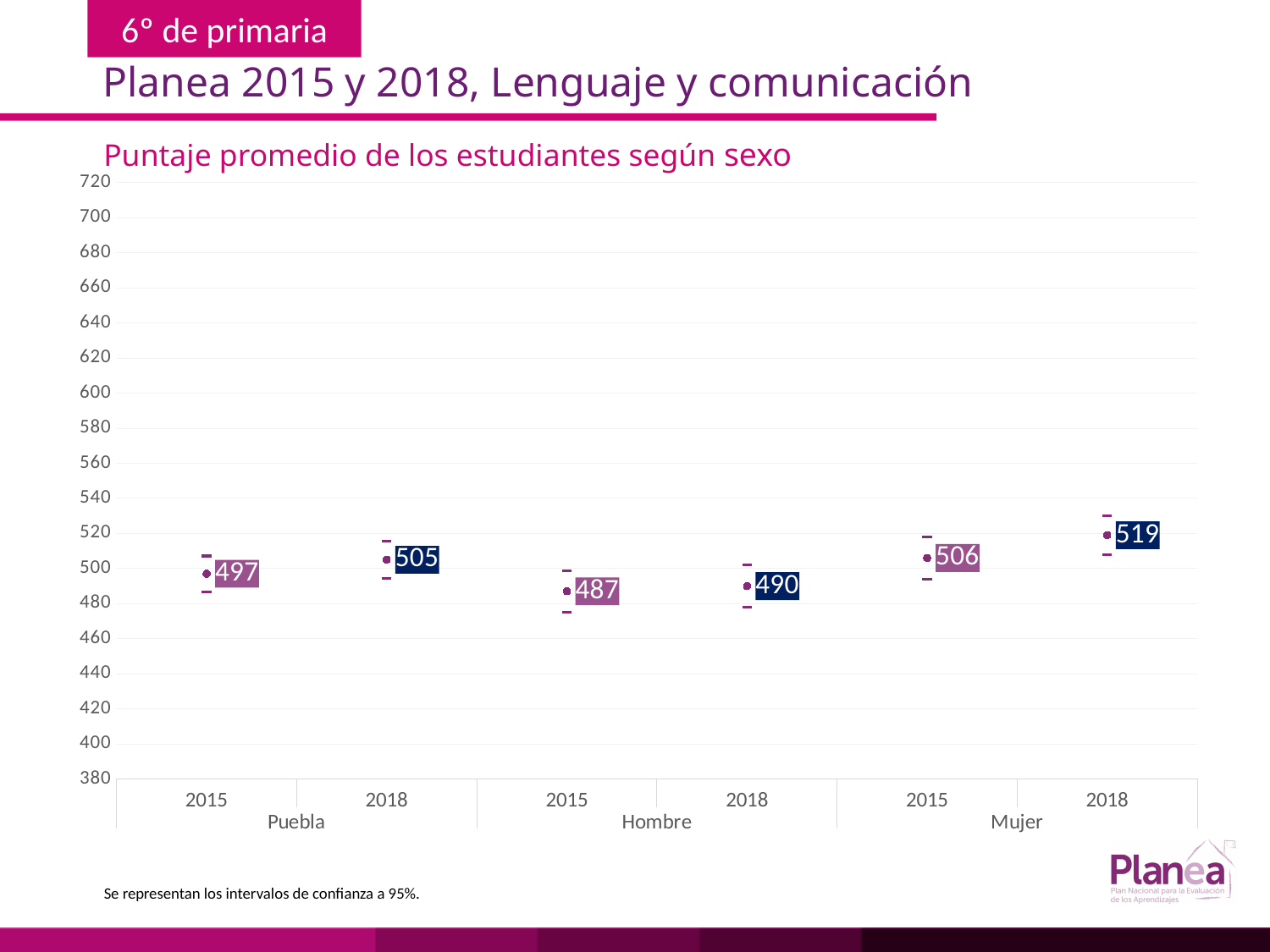
How many data points are plotted on the chart? 6 Which group and year has the lowest average score? Hombre 2015 What is the average score for Mujer in 2015? 506 Which is larger, the Hombre score in 2018 or the Puebla score in 2015? Puebla 2015 What is the average score for Hombre in 2018? 490 What is the average score for Puebla in 2015? 497 What is the difference between the Puebla score in 2018 and the Puebla score in 2015? 8 What is the title of the chart? Puntaje promedio de los estudiantes según sexo Does the average score for Hombre rise or fall from 2015 to 2018? rise What is the difference between the Mujer score in 2018 and the Mujer score in 2015? 13 What is the average score for Mujer in 2018? 519 Which group and year has the highest average score? Mujer 2018